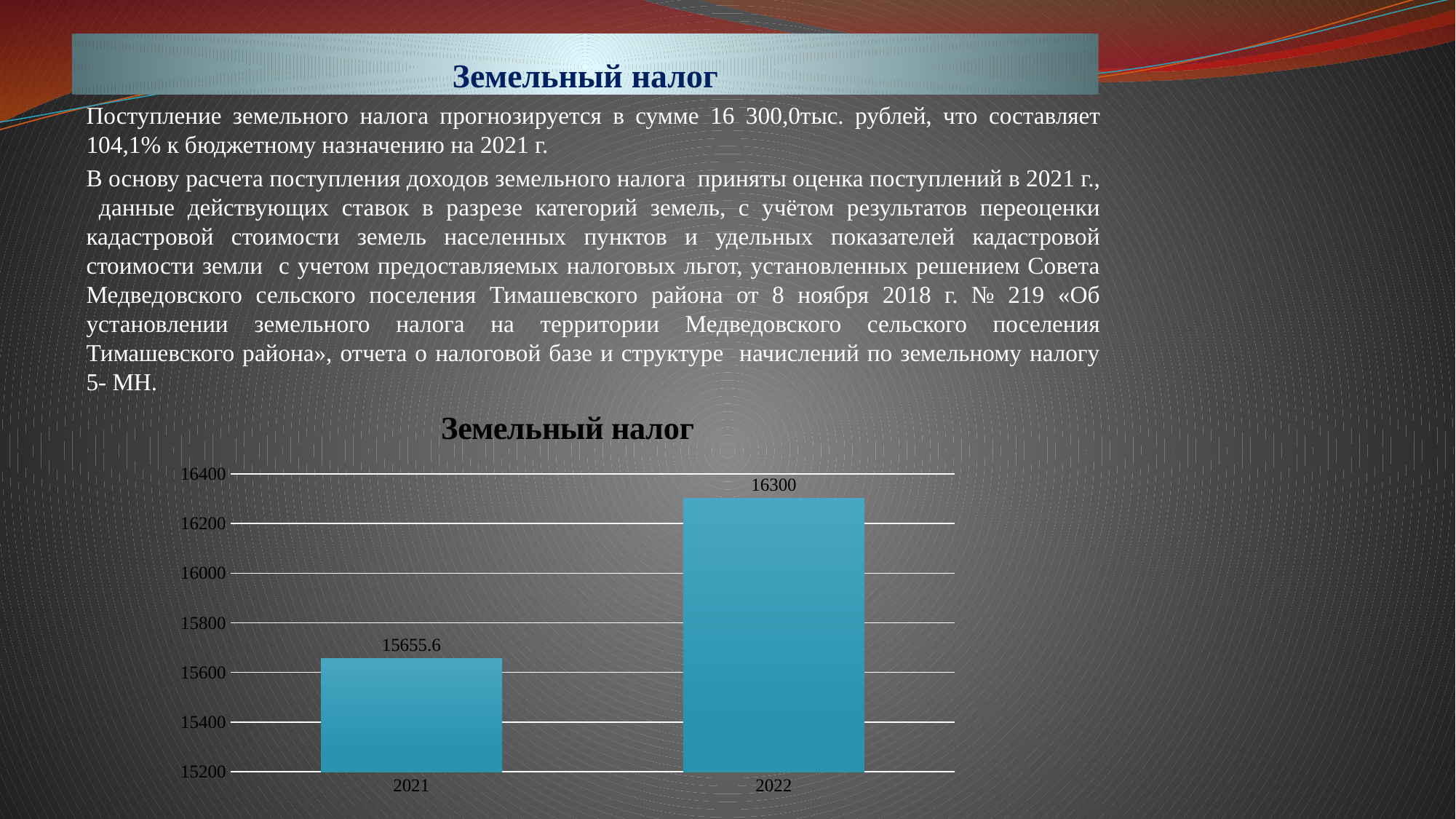
Which year has the lowest value in the chart? 2021 Which is larger, the value for 2021 or the value for 2022? 2022 How many categories are shown in the chart? 2 What is the title of the chart? Земельный налог Is the value for 2021 greater or less than 15800? less What is the difference between the values for 2022 and 2021? 644.4 Do the values rise or fall from 2021 to 2022? rise Is the value for 2022 greater or less than 16200? greater What is the value for 2022 in the chart? 16300 Which year has the highest value in the chart? 2022 What is the value for 2021 in the chart? 15655.6 What kind of chart is shown on the slide? bar chart